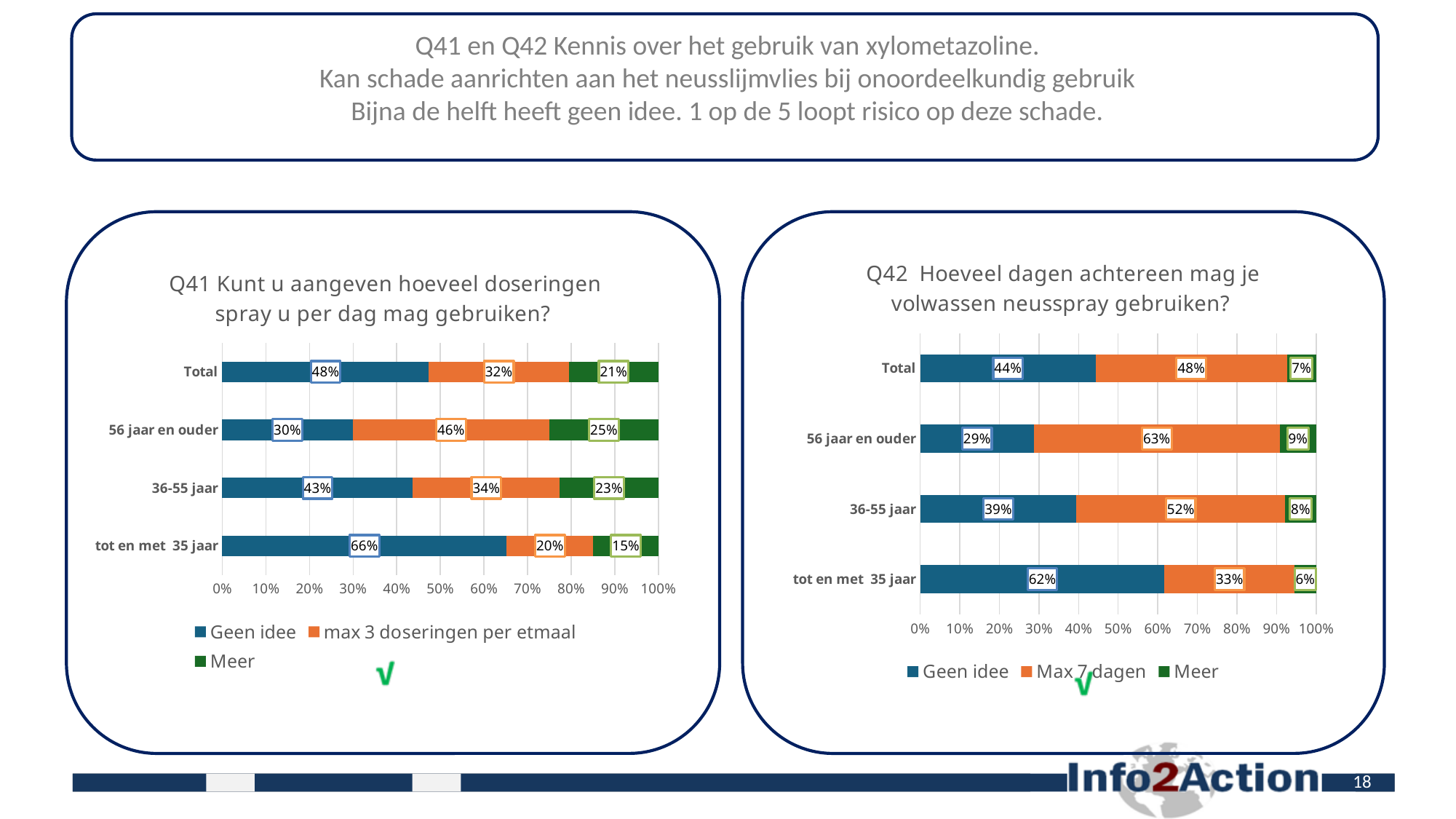
In the Q41 chart, what is the 'max 3 doseringen per etmaal' value for '56 jaar en ouder'? 46% In the Q42 chart, what percentage of the Total answered 'Geen idee'? 44% What type of chart is the Q42 chart? Stacked bar chart In the Q42 chart, what is the 'Max 7 dagen' value for '56 jaar en ouder'? 63% In the Q41 chart, which age group has the highest 'Geen idee' share? tot en met 35 jaar How many series does the legend of the Q42 chart list? 3 In the Q42 chart, is the 'Geen idee' value for '36-55 jaar' larger or smaller than the 'Max 7 dagen' value for the same group? smaller In the Q41 chart, what percentage of the 'tot en met 35 jaar' group answered 'Geen idee'? 66% In the Q41 chart, which category has the lowest 'Meer' value? tot en met 35 jaar In the Q41 chart, what is the difference between the 'Geen idee' values for 'tot en met 35 jaar' and '56 jaar en ouder'? 36 percentage points In the Q42 chart, which age group has the highest 'Max 7 dagen' share? 56 jaar en ouder How many categories are shown in the Q41 chart? 4